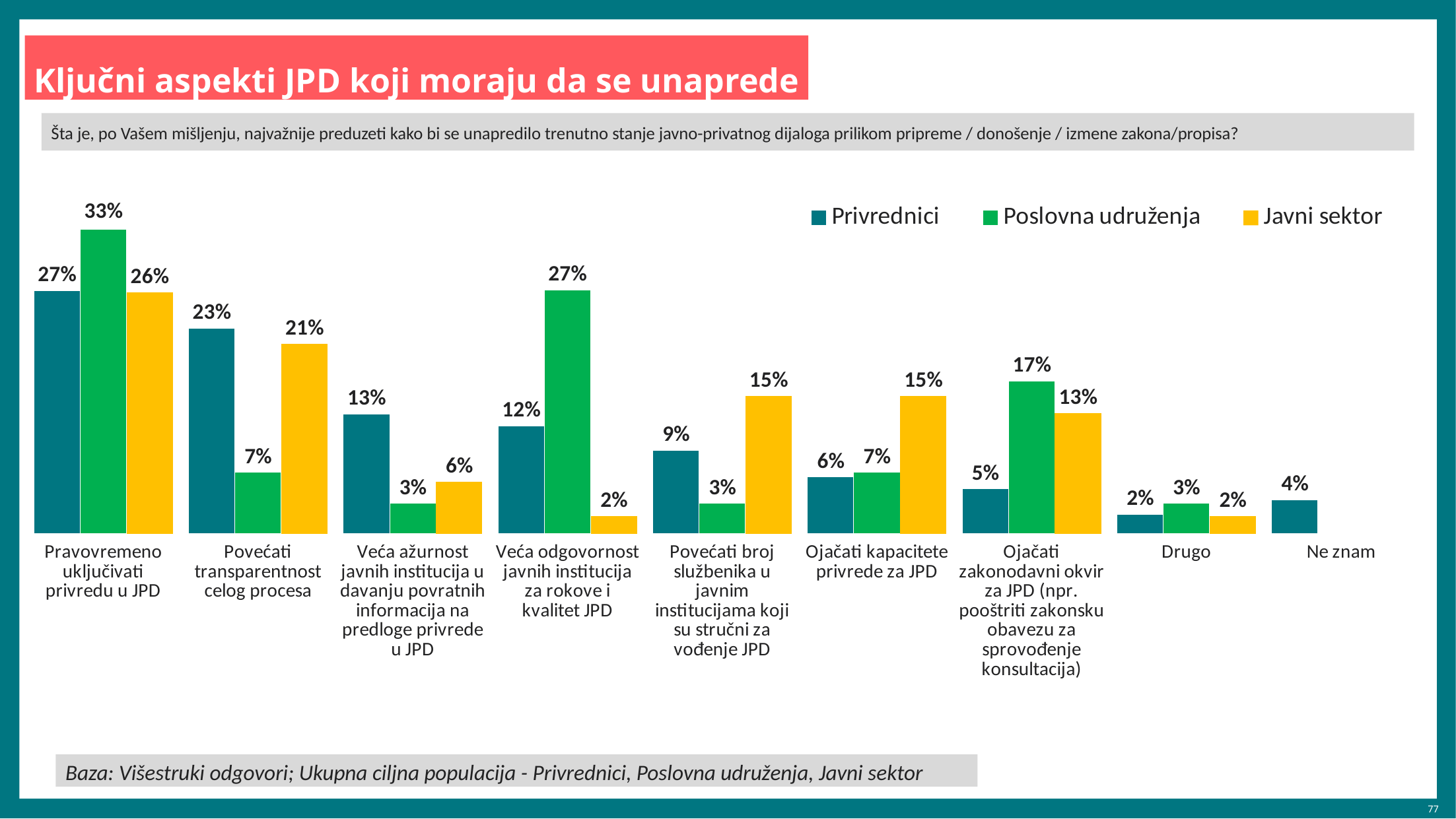
What is the value for Privrednici in the category "Ne znam"? 4% How many categories are shown on the x axis? 9 Which category has the lowest value for Privrednici? Drugo What is the value for Poslovna udruženja in the category "Pravovremeno uključivati privredu u JPD"? 33% Which category has the highest value for Javni sektor? Pravovremeno uključivati privredu u JPD What is the value for Javni sektor in the category "Povećati transparentnost celog procesa"? 21% What is the difference between the Privrednici and Poslovna udruženja values in the category "Ojačati zakonodavni okvir za JPD"? 12% Which colour represents the Poslovna udruženja series? green What kind of chart is shown on the slide? bar chart How many series does the legend list? 3 What is the difference between the Poslovna udruženja and Javni sektor values in the category "Veća odgovornost javnih institucija za rokove i kvalitet JPD"? 25% In the category "Ojačati kapacitete privrede za JPD", which series has the larger value: Privrednici or Javni sektor? Javni sektor